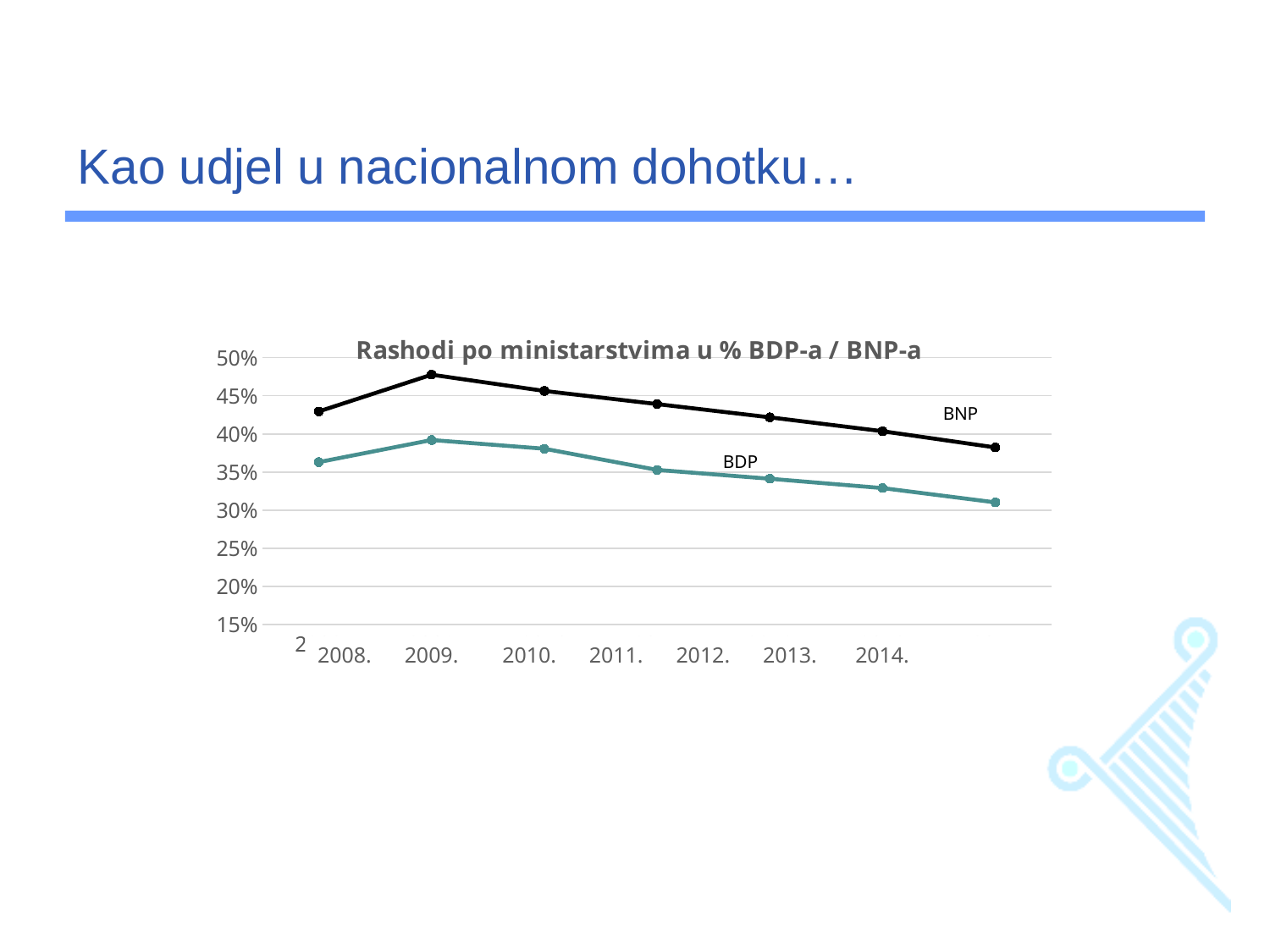
Which series is higher in 2010, BNP or BDP? BNP Is the BDP value for 2014 greater or less than 30%? greater Is the BNP value for 2014 greater or less than 40%? less Do the BNP values rise or fall from 2009 to 2014? fall How many series are plotted in the chart? 2 Is the BDP value for 2012 greater or less than 35%? less What kind of chart is shown on the slide? line chart In which year does the BDP series reach its lowest value? 2014. In which year does the BNP series reach its highest value? 2009. How many years are plotted along the x axis of the chart? 7 What is the title of the chart? Rashodi po ministarstvima u % BDP-a / BNP-a